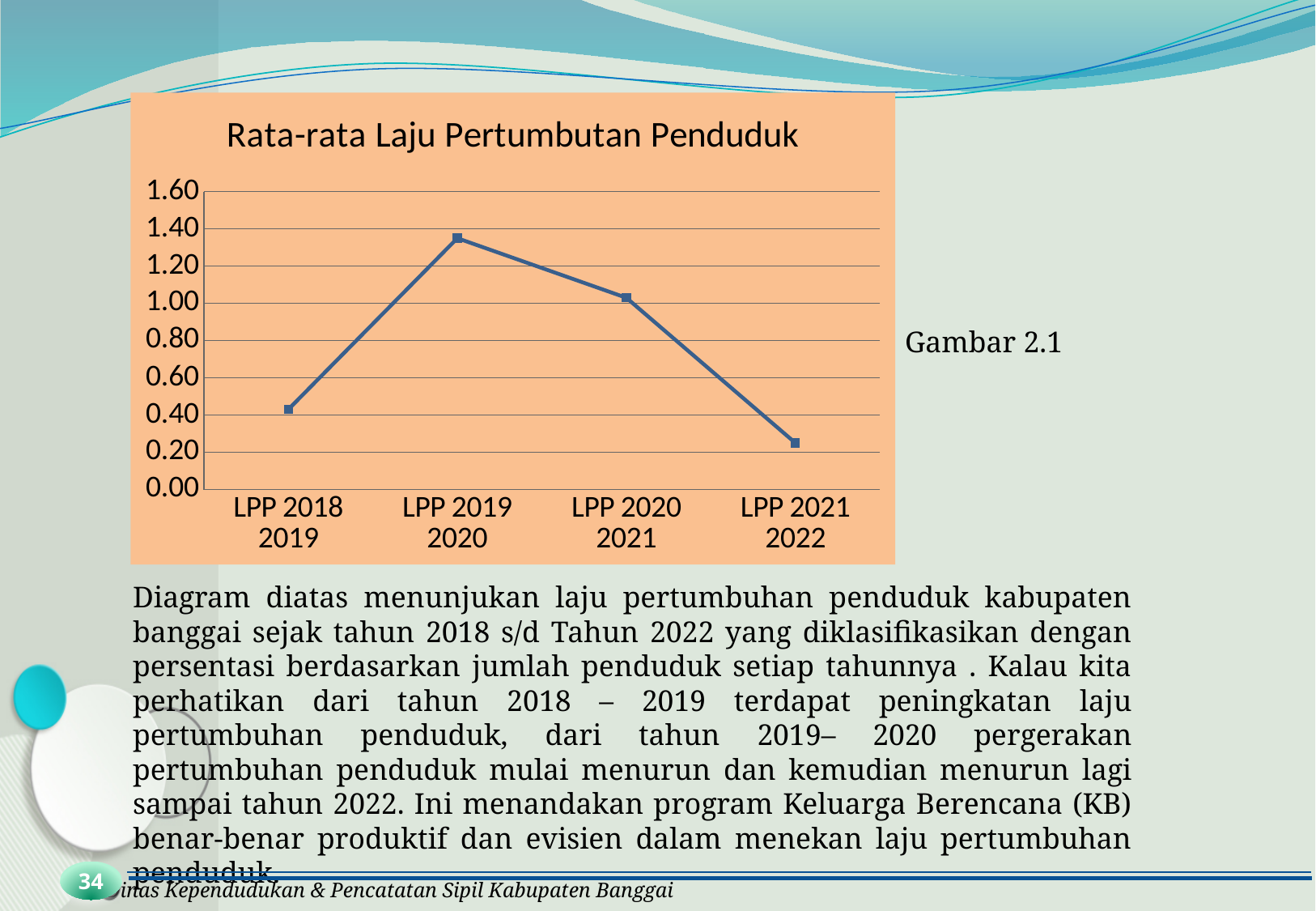
How many data points are plotted on the line? 4 Is the value for LPP 2021 2022 greater or less than 0.40? less Which is larger, the value for LPP 2018 2019 or the value for LPP 2021 2022? LPP 2018 2019 Is the value for LPP 2020 2021 greater or less than 0.80? greater Is the value for LPP 2019 2020 greater or less than 1.20? greater Which category has the lowest value? LPP 2021 2022 What is the title of the chart? Rata-rata Laju Pertumbutan Penduduk What kind of chart is shown on the slide? line chart Which category has the highest value? LPP 2019 2020 Which is larger, the value for LPP 2019 2020 or the value for LPP 2020 2021? LPP 2019 2020 Do the values rise or fall from LPP 2019 2020 to LPP 2021 2022? fall